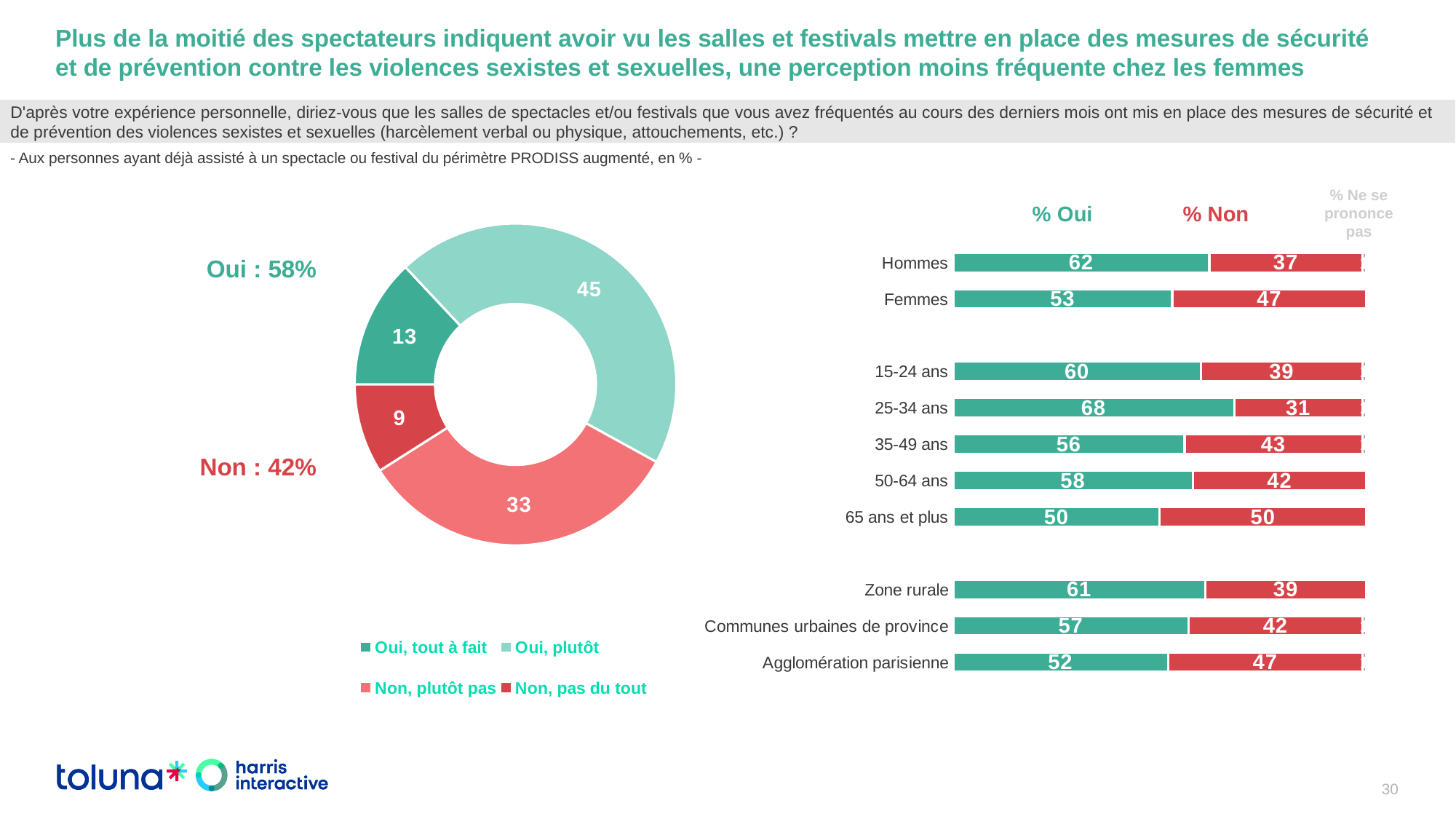
In the donut chart on the left, what value is shown for the 'Oui, plutôt' slice? 45 In the bar chart on the right, what is the '% Non' value for '35-49 ans'? 43 In the bar chart on the right, which category has the lowest '% Oui' value? 65 ans et plus In the bar chart on the right, which category has the highest '% Oui' value? 25-34 ans In the donut chart on the left, what value is shown for the 'Non, pas du tout' slice? 9 In the donut chart on the left, what is the combined share of the two 'Oui' slices, as printed on the slide? 58% In the bar chart on the right, what is the '% Oui' value for 'Femmes'? 53 What kind of chart is shown on the right side of the slide? Bar chart In the bar chart on the right, what is the difference between the '% Oui' values for 'Hommes' and 'Femmes'? 9 In the donut chart on the left, how many slices does the legend list? 4 In the bar chart on the right, which has a higher '% Non' value: 'Zone rurale' or 'Agglomération parisienne'? Agglomération parisienne In the donut chart on the left, which slice is the largest? Oui, plutôt